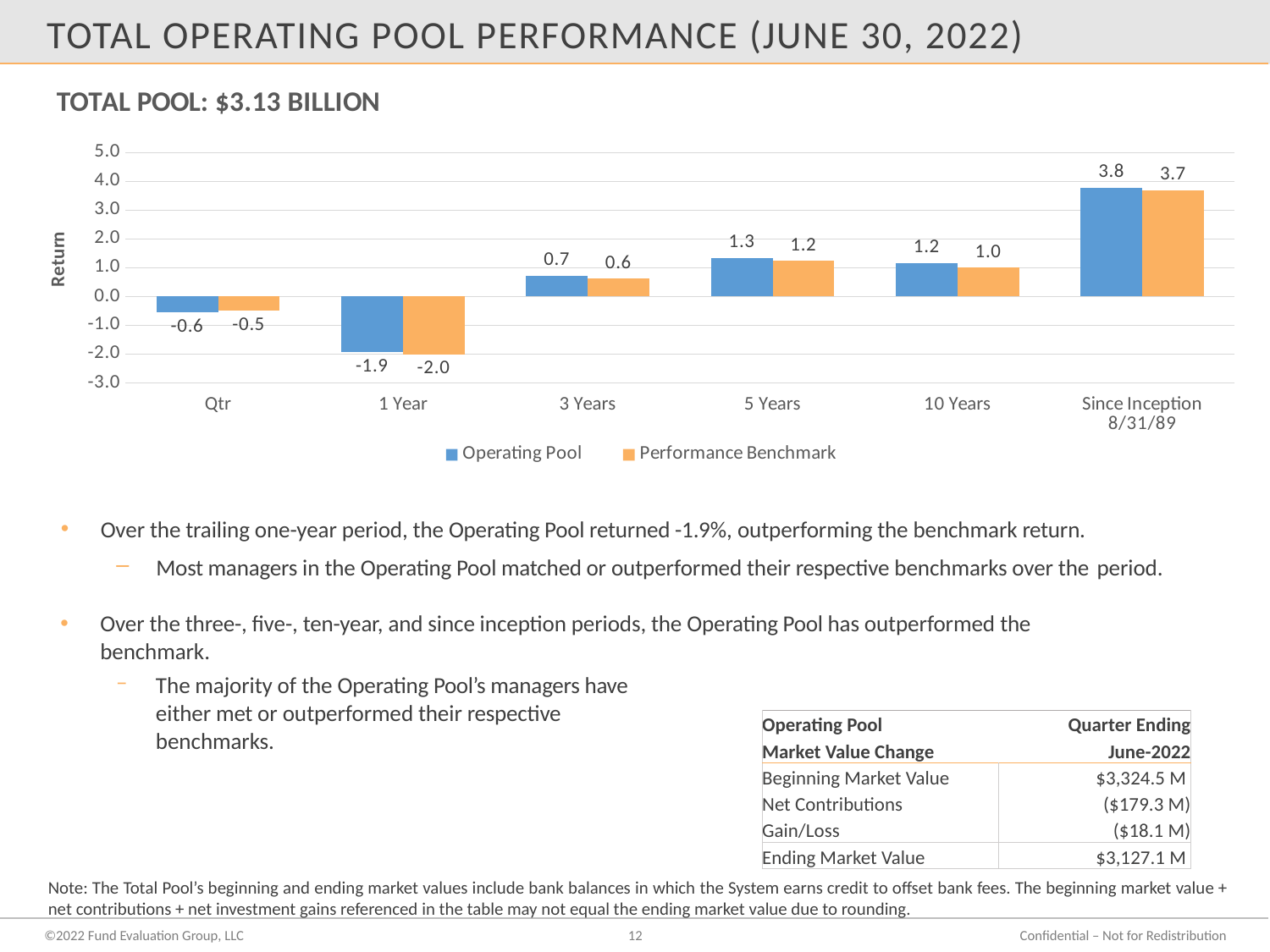
How many series does the chart legend list? 2 What is the difference between the Operating Pool and Performance Benchmark returns for the 10 Years period? 0.2 What is the Performance Benchmark return for the Qtr period? -0.5 What kind of chart is shown on the slide? Bar chart Which period has the lowest Performance Benchmark return? 1 Year How many periods are shown on the x axis of the chart? 6 What is the Performance Benchmark return for the 5 Years period? 1.2 For the 3 Years period, which is larger: the Operating Pool return or the Performance Benchmark return? Operating Pool What is the label of the vertical axis of the chart? Return What is the Operating Pool return for the Since Inception 8/31/89 period? 3.8 What is the Operating Pool return for the 1 Year period? -1.9 Which period has the highest Operating Pool return? Since Inception 8/31/89